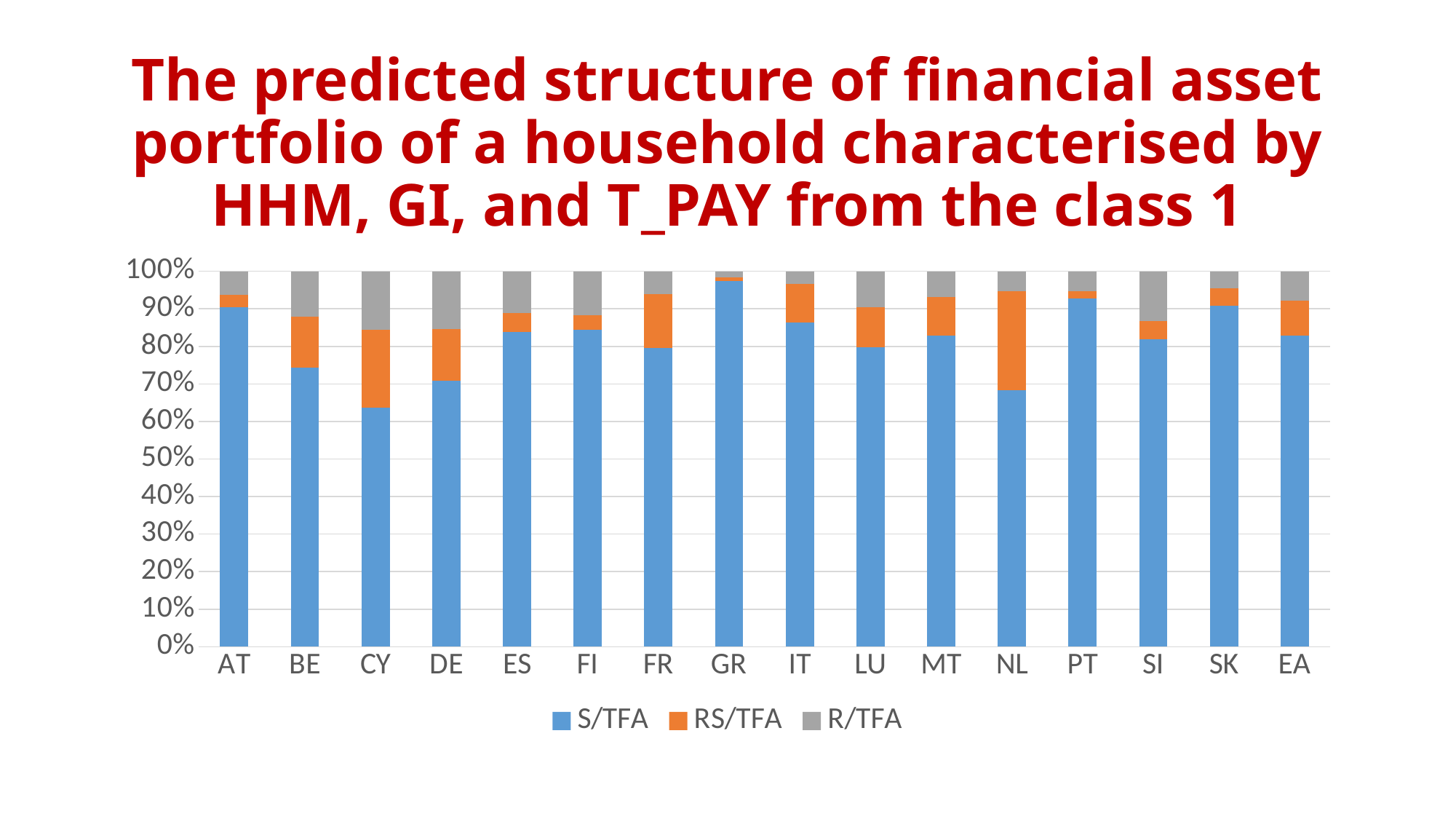
Which series is shown in orange in the legend? RS/TFA Which category has the lowest S/TFA share? CY What kind of chart is shown on the slide? Stacked bar chart What is the total of the stacked bar for AT? 100% Is the S/TFA value for BE greater or less than 80%? less Is the S/TFA value for GR greater or less than 90%? greater Which has a larger S/TFA share, PT or BE? PT Is the S/TFA value for CY greater or less than 70%? less How many series does the legend list? 3 Which category has the largest RS/TFA segment? NL Which category has the highest S/TFA share? GR How many countries/categories are shown on the x axis? 16